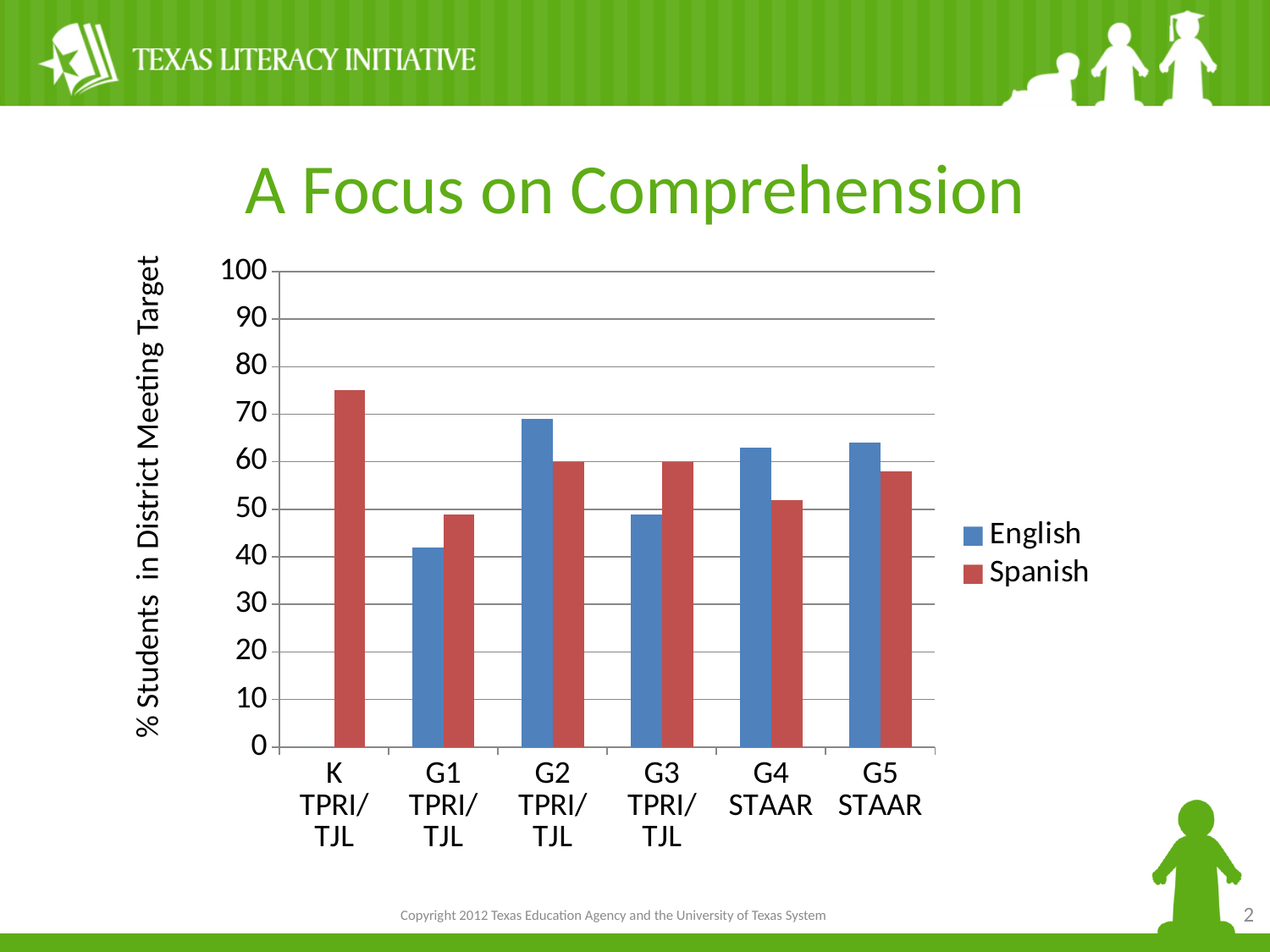
Is the English value for G1 TPRI/TJL greater or less than 50? less Which category has the highest Spanish value? K TPRI/TJL What kind of chart is shown on the slide? bar chart What is the label on the vertical axis of the chart? % Students in District Meeting Target For G4 STAAR, which is larger, the English or the Spanish value? English For G1 TPRI/TJL, which is larger, the English or the Spanish value? Spanish How many grade categories are shown on the x axis? 6 For G2 TPRI/TJL, which is larger, the English or the Spanish value? English How many series does the legend list? 2 Which category has the highest English value? G2 TPRI/TJL Is the Spanish value for K TPRI/TJL greater or less than 70? greater